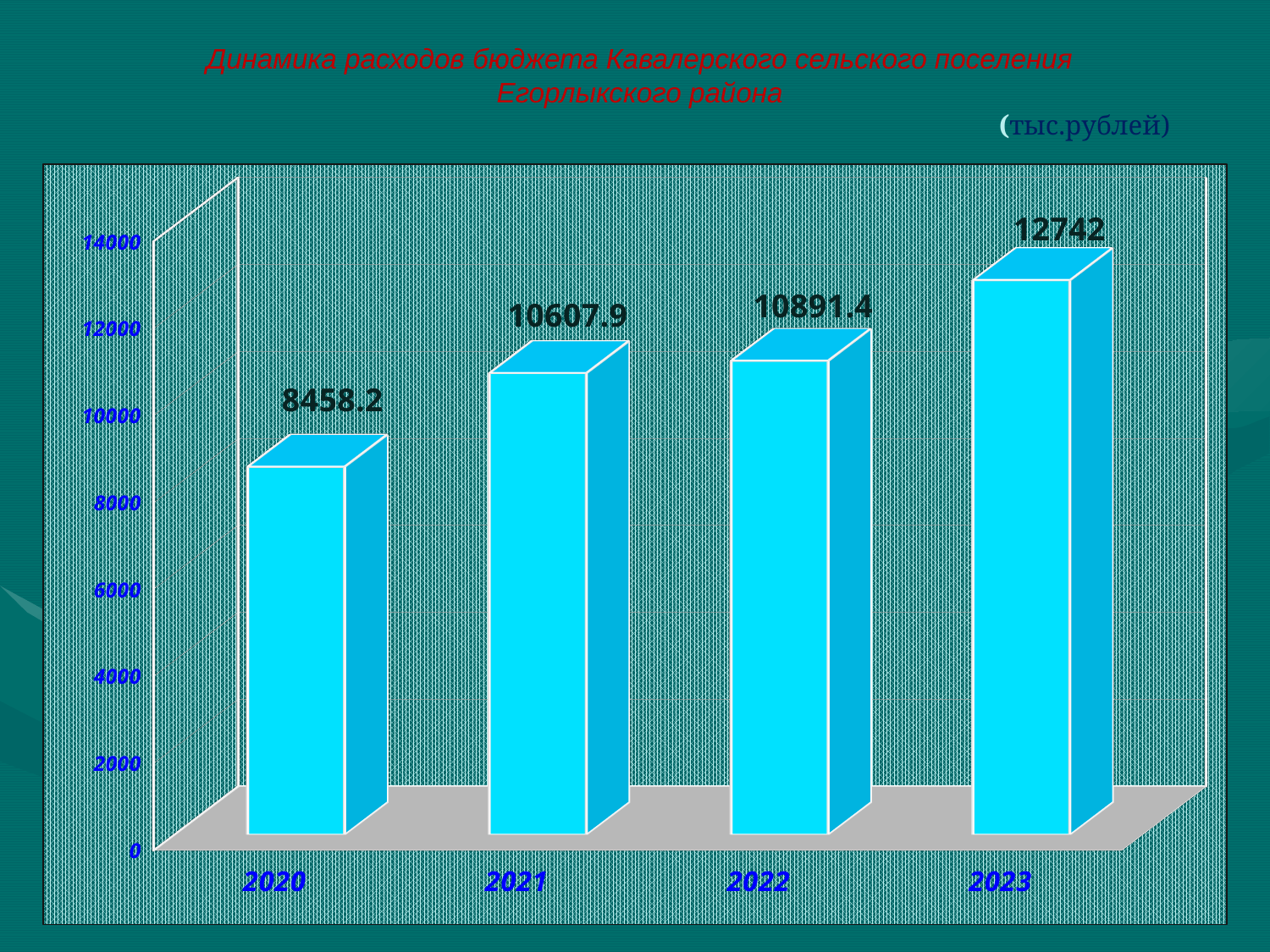
What is the value for 2022? 10891.4 What is the difference between the values for 2022 and 2021? 283.5 Which is larger, the value for 2021 or the value for 2023? 2023 Which year has the highest value? 2023 What is the value for 2020? 8458.2 Is the value for 2020 greater or less than 10000? less Do the values rise or fall from 2020 to 2023? rise What is the value for 2021? 10607.9 What is the difference between the values for 2023 and 2020? 4283.8 What is the value for 2023? 12742 How many years are shown on the chart? 4 Which year has the lowest value? 2020